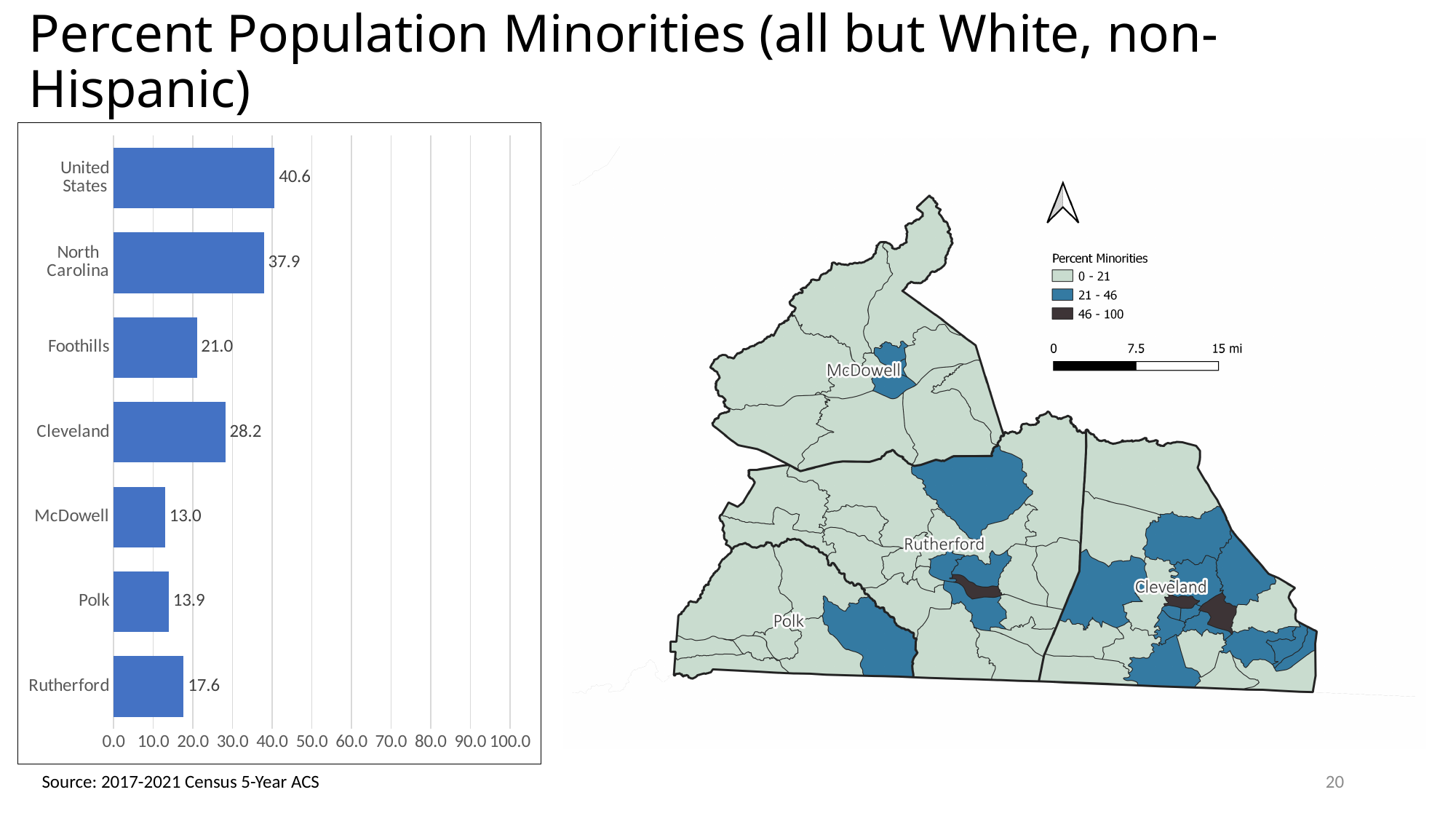
What is the highest value on the x axis of the bar chart? 100.0 What is the value for Rutherford in the bar chart? 17.6 Which category has the highest value in the bar chart? United States What is the value for the United States in the bar chart? 40.6 What kind of chart is on the left of the slide? bar chart Which is larger in the bar chart, Polk or McDowell? Polk How many categories are shown in the bar chart? 7 What is the difference between the United States and North Carolina values in the bar chart? 2.7 Is the value for Rutherford in the bar chart greater or less than 20.0? less What is the difference between the Cleveland and Foothills values in the bar chart? 7.2 Which category has the lowest value in the bar chart? McDowell What is the value for Cleveland in the bar chart? 28.2